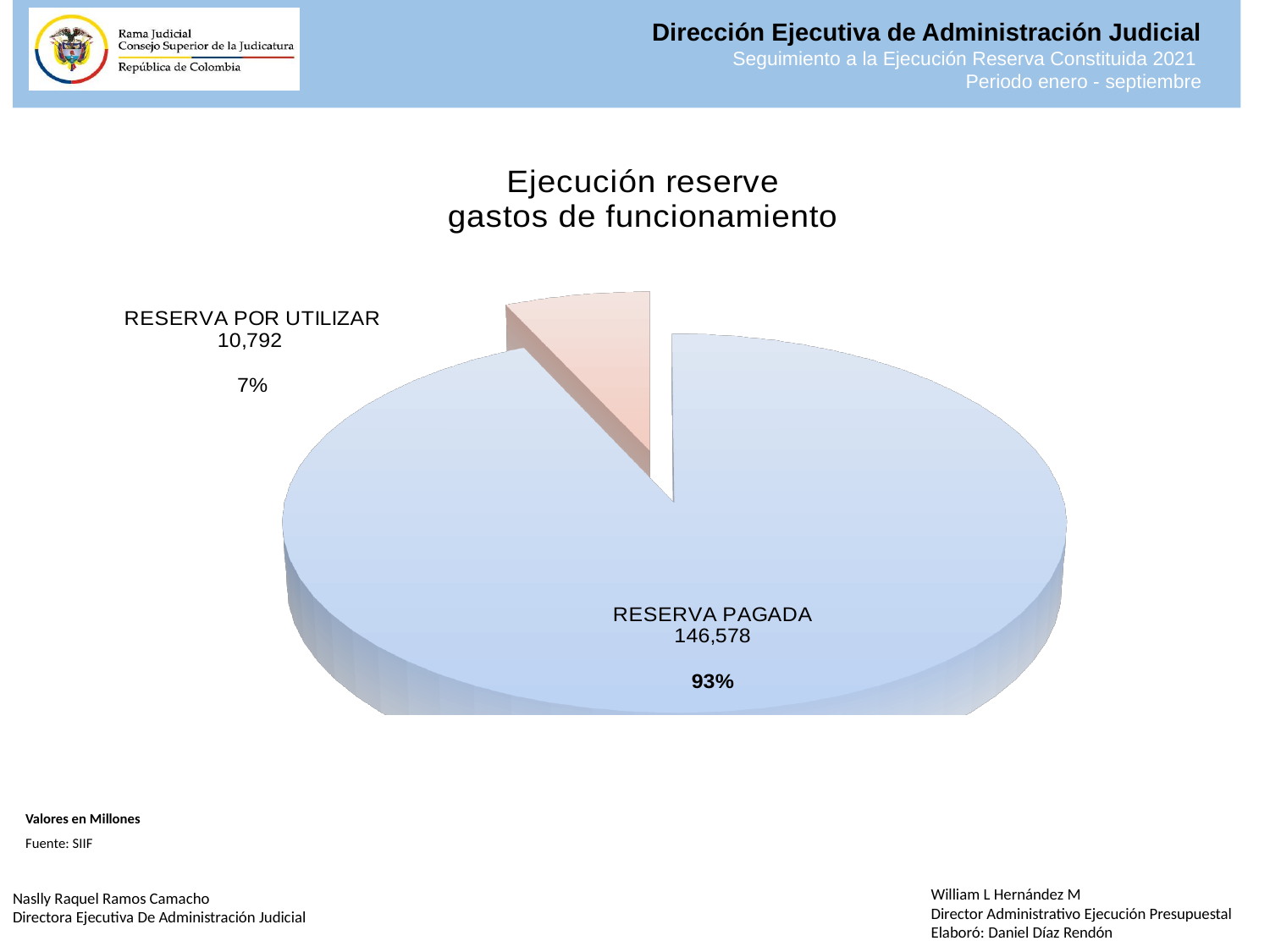
What is the title of the chart? Ejecución reserve gastos de funcionamiento What kind of chart is shown on the slide? Pie chart What is the total of the two slices in the pie chart? 157,370 Which is larger, RESERVA PAGADA or RESERVA POR UTILIZAR? RESERVA PAGADA What share of the pie does RESERVA POR UTILIZAR represent? 7% What share of the pie does RESERVA PAGADA represent? 93% What is the difference between RESERVA PAGADA and RESERVA POR UTILIZAR? 135,786 Which slice is the smallest? RESERVA POR UTILIZAR How many slices does the pie chart have? 2 Which slice is the largest? RESERVA PAGADA What is the value for RESERVA POR UTILIZAR? 10,792 What is the value for RESERVA PAGADA? 146,578